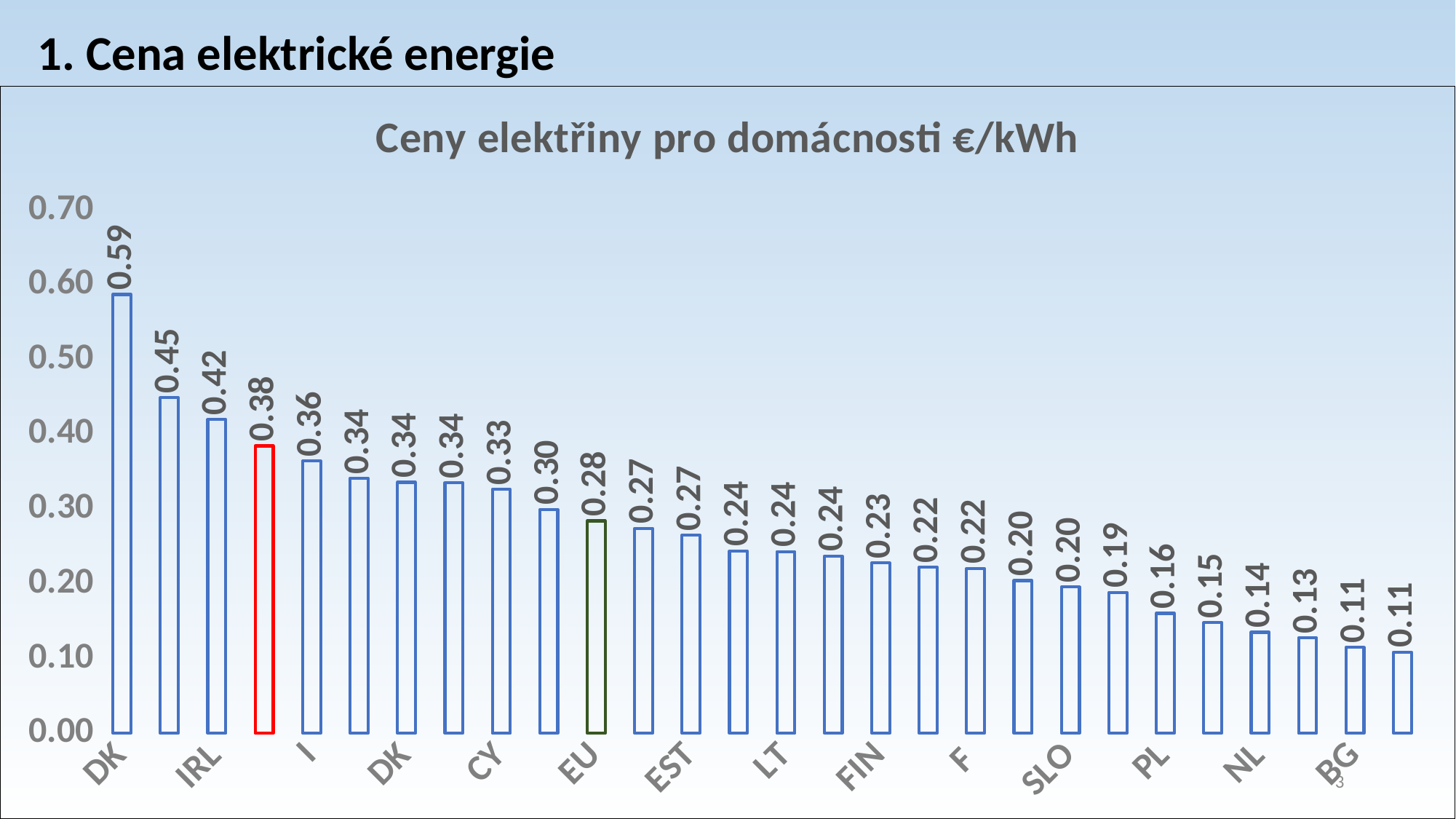
What is the value for PL? 0.16 What is the difference between the values for IRL and EU? 0.14 What is the value of the bar outlined in red? 0.38 What is the value of the highest bar in the chart? 0.59 What is the value for EU? 0.28 What is the value for IRL? 0.42 What is the value for BG? 0.11 Do the values rise or fall from left to right along the x axis? fall What kind of chart is shown on the slide? bar chart Which has a larger value, CY or FIN? CY What is the title of the chart? Ceny elektřiny pro domácnosti €/kWh How many bars are plotted in the chart? 28